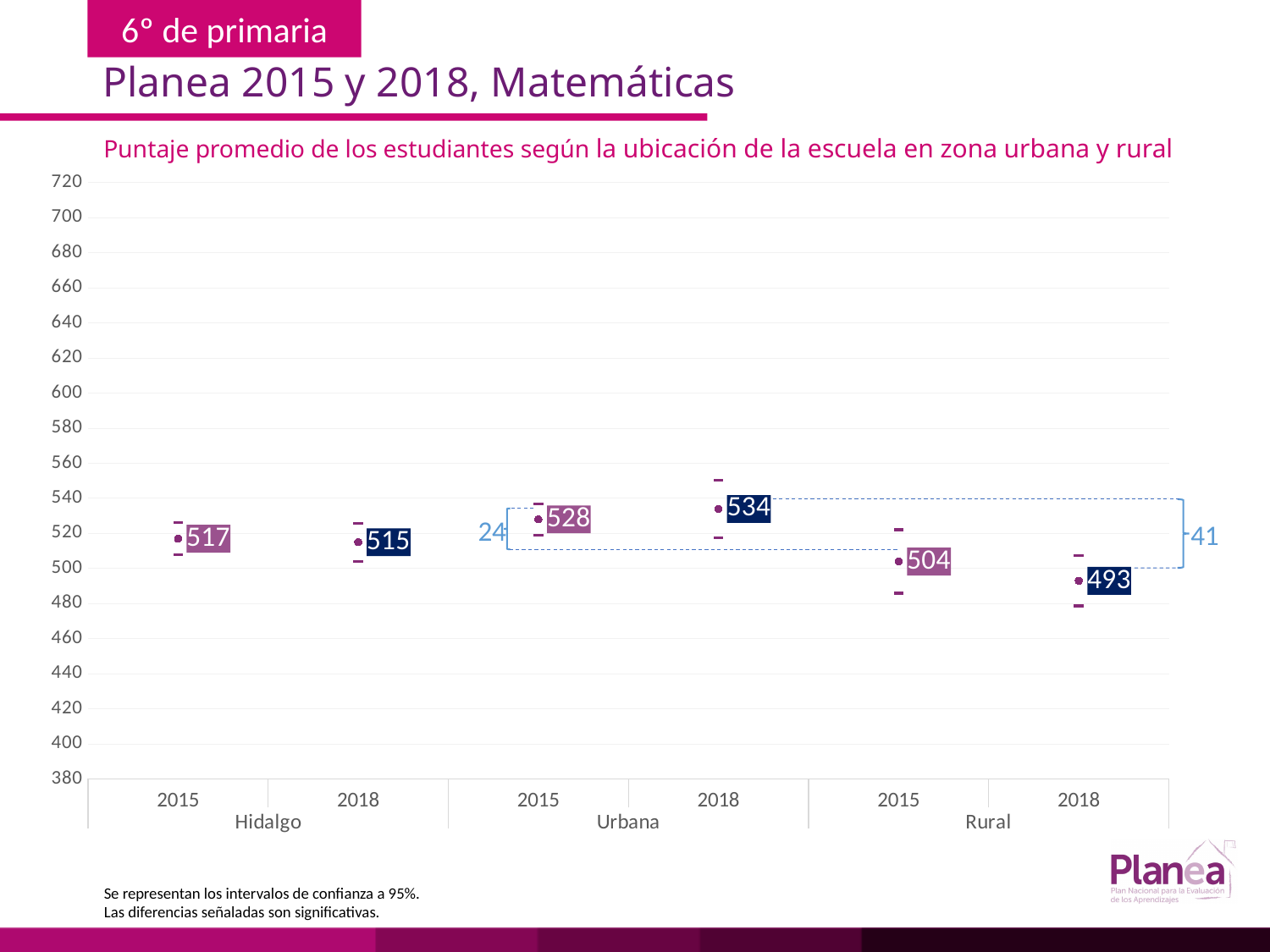
Which group and year has the lowest average score? Rural 2018 Which is larger, the Rural score in 2015 or the Rural score in 2018? Rural 2015 Which group and year has the highest average score? Urbana 2018 What is the lowest value shown on the vertical axis? 380 What is the difference between the Urbana and Rural average scores in 2015? 24 What is the average score for Rural schools in 2018? 493 What is the difference between the Urbana and Rural average scores in 2018? 41 What is the average score for Urbana schools in 2018? 534 What is the difference between the Hidalgo scores in 2015 and 2018? 2 What is the average score for Hidalgo in 2015? 517 Did the Urbana average score rise or fall from 2015 to 2018? rise